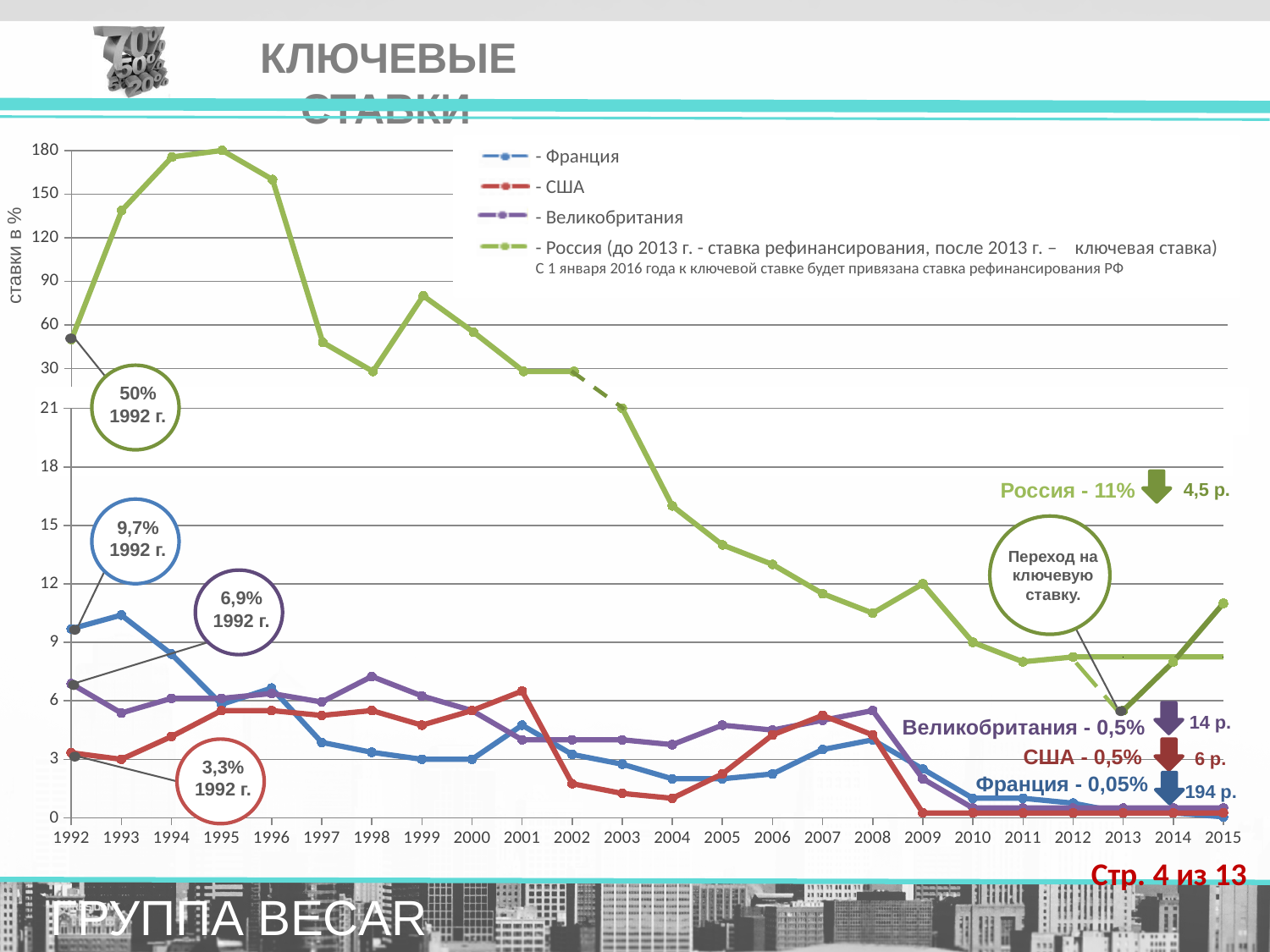
What was the key rate for Russia (Россия) in 1992, as labelled on the chart? 50% Which country had the highest rate in 1992? Россия How many series does the legend list? 4 What is the rate for Russia (Россия) at the end of the chart, as labelled? 11% Which was larger in 1992: the rate for the United Kingdom or the rate for the USA? Великобритания What was the rate for France (Франция) in 1992, as labelled on the chart? 9,7% What is the difference between the 1992 rates of France (9,7%) and the USA (3,3%)? 6,4% What was the rate for the United Kingdom (Великобритания) in 1992, as labelled on the chart? 6,9% Is the value for Russia in 1995 greater or less than 150? greater Which country has the lowest rate at the end of the chart (Франция - 0,05%, США - 0,5%, Великобритания - 0,5%, Россия - 11%)? Франция What kind of chart is shown on the slide? line chart What was the rate for the USA (США) in 1992, as labelled on the chart? 3,3%